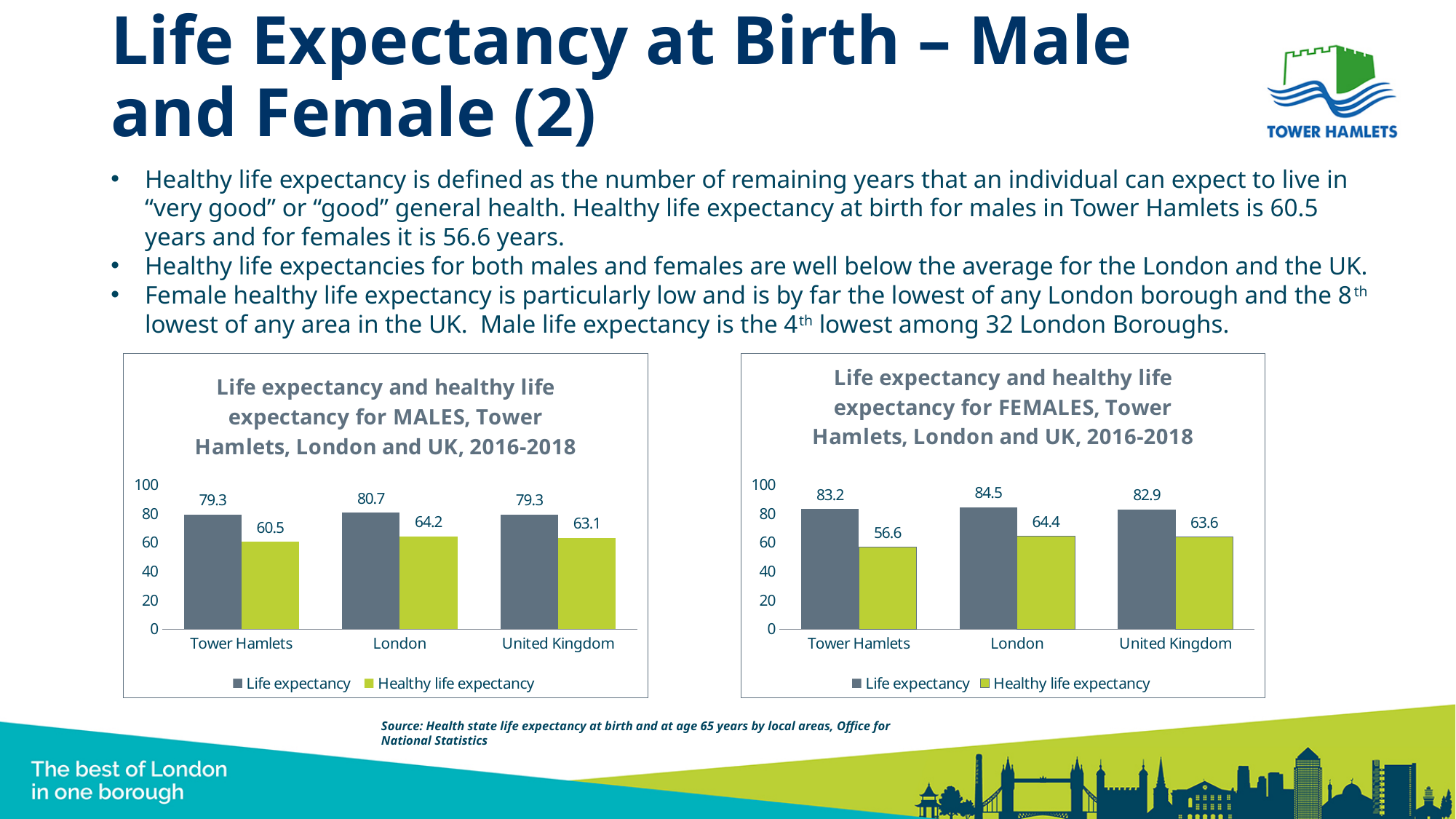
In the FEMALES chart on the right, is the healthy life expectancy for the United Kingdom higher or lower than for Tower Hamlets? higher In the FEMALES chart on the right, what is the life expectancy for London? 84.5 In the FEMALES chart on the right, what is the difference between the healthy life expectancy for London and for Tower Hamlets? 7.8 In the MALES chart on the left, what colour are the Healthy life expectancy bars? green In the MALES chart on the left, is the healthy life expectancy for Tower Hamlets greater or less than 80? less In the MALES chart on the left, what is the healthy life expectancy for Tower Hamlets? 60.5 In the MALES chart on the left, which area has the highest life expectancy? London In the FEMALES chart on the right, which area has the lowest healthy life expectancy? Tower Hamlets What type of chart is the FEMALES chart on the right? bar chart How many areas are shown on the x axis of the FEMALES chart on the right? 3 How many series does the legend of the MALES chart on the left list? 2 In the MALES chart on the left, what is the difference between life expectancy and healthy life expectancy for London? 16.5